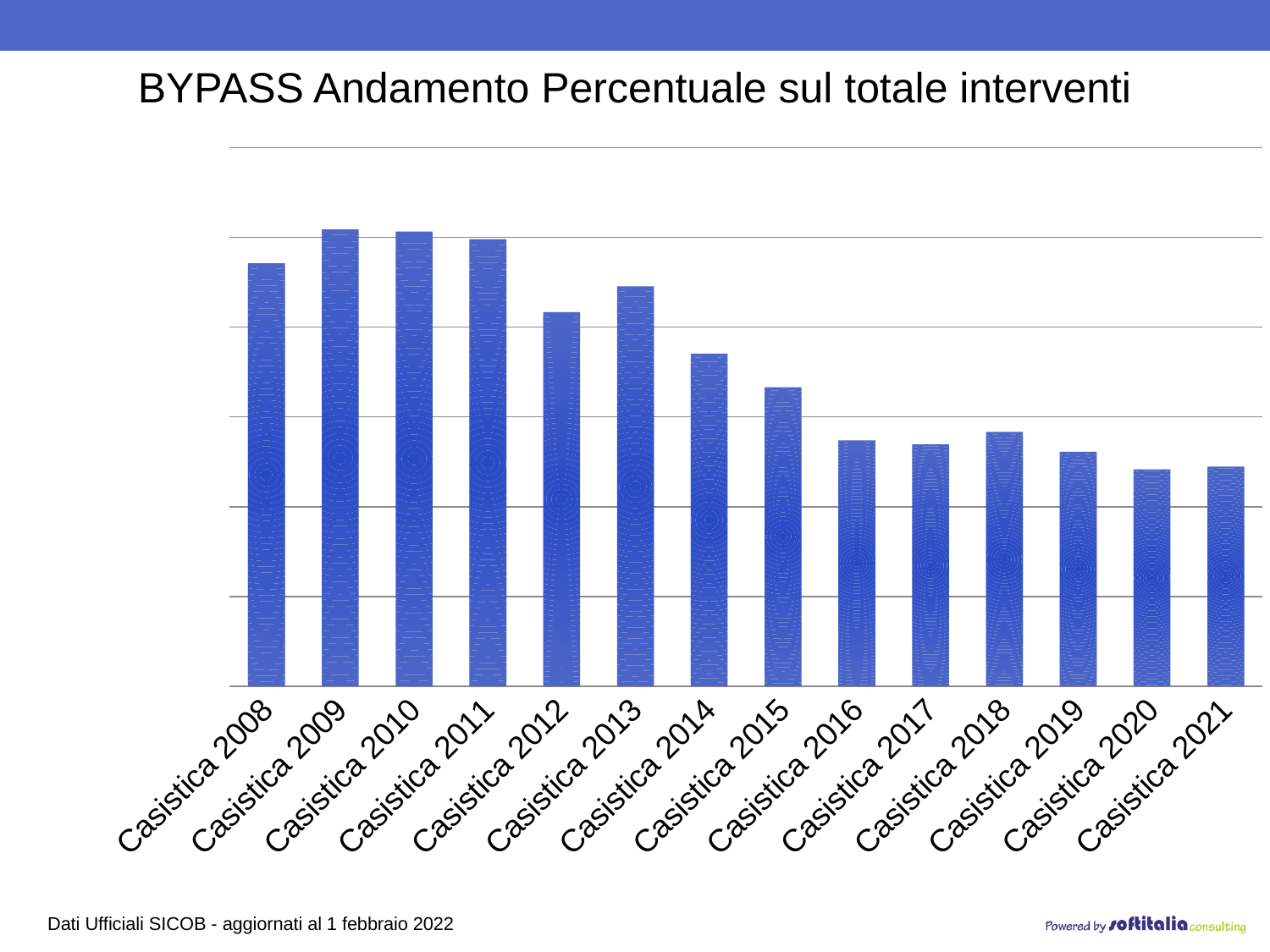
What is the first category on the x axis? Casistica 2008 What is the title of the chart? BYPASS Andamento Percentuale sul totale interventi Which is larger, the value for Casistica 2015 or Casistica 2020? Casistica 2015 Overall, do the values rise or fall from Casistica 2008 to Casistica 2021? Fall Which is larger, the value for Casistica 2011 or Casistica 2014? Casistica 2011 What kind of chart is shown on the slide? Bar chart Which is larger, the value for Casistica 2012 or Casistica 2013? Casistica 2013 How many categories (bars) are plotted on the chart? 14